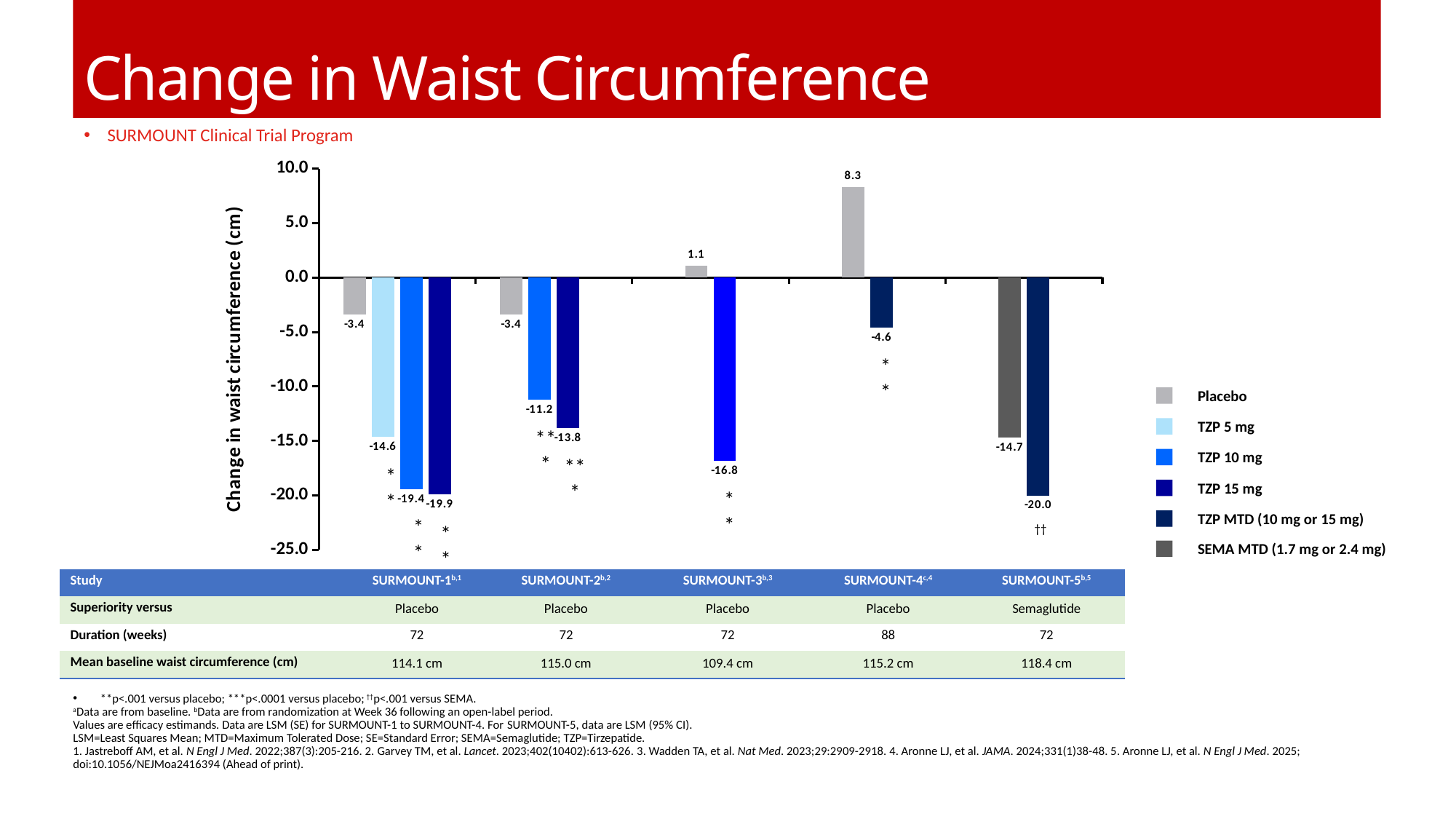
Which bar shows the highest (most positive) change in waist circumference? Placebo in SURMOUNT-4 What is the change in waist circumference for TZP 10 mg in SURMOUNT-2? -11.2 How many series does the legend list? 6 In SURMOUNT-3, what is the difference between the Placebo and TZP MTD changes in waist circumference? 17.9 Which bar shows the lowest (most negative) change in waist circumference? TZP MTD in SURMOUNT-5 What is the label of the vertical axis? Change in waist circumference (cm) What is the change in waist circumference for SEMA MTD in SURMOUNT-5? -14.7 What kind of chart is shown on the slide? Bar chart What is the change in waist circumference for Placebo in SURMOUNT-4? 8.3 Which study has the larger Placebo change in waist circumference, SURMOUNT-3 or SURMOUNT-4? SURMOUNT-4 In SURMOUNT-5, what is the difference between the TZP MTD and SEMA MTD changes in waist circumference? 5.3 What is the change in waist circumference for TZP 15 mg in SURMOUNT-1? -19.9